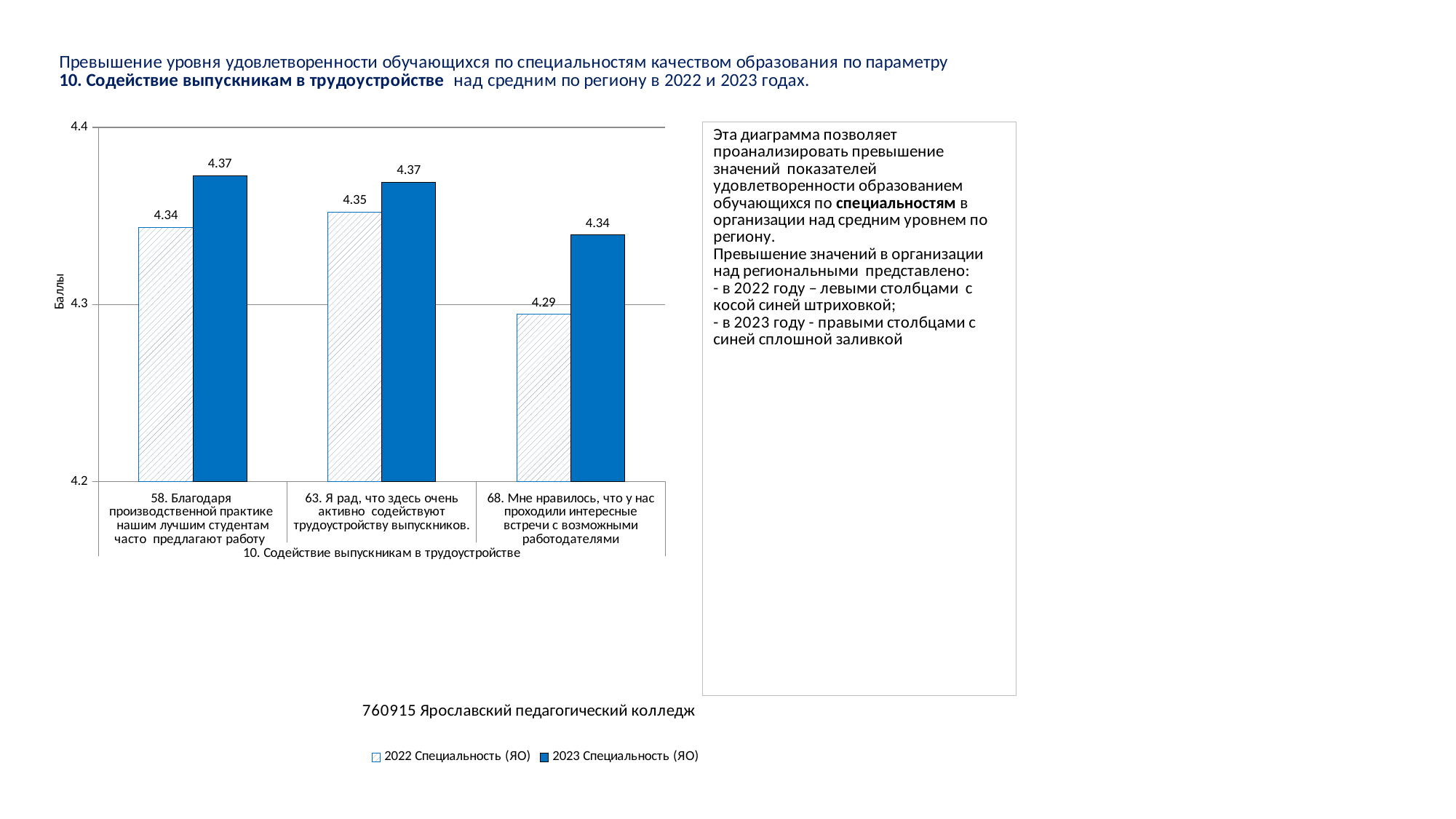
Which is larger for category 63: the 2022 Специальность (ЯО) value or the 2023 Специальность (ЯО) value? 2023 Специальность (ЯО) Which category has the lowest 2023 Специальность (ЯО) value? 68. Мне нравилось, что у нас проходили интересные встречи с возможными работодателями What is the 2023 Специальность (ЯО) value for category 68 (Мне нравилось, что у нас проходили интересные встречи с возможными работодателями)? 4.34 What is the difference between the 2023 and 2022 values for category 68 (Мне нравилось, что у нас проходили интересные встречи с возможными работодателями)? 0.05 What is the 2022 Специальность (ЯО) value for category 68 (Мне нравилось, что у нас проходили интересные встречи с возможными работодателями)? 4.29 Which category has the lowest 2022 Специальность (ЯО) value? 68. Мне нравилось, что у нас проходили интересные встречи с возможными работодателями How many series does the chart legend list? 2 How many categories are shown on the x axis of the chart? 3 What is the difference between the 2023 and 2022 values for category 58 (Благодаря производственной практике нашим лучшим студентам часто предлагают работу)? 0.03 Is the 2022 Специальность (ЯО) value for category 68 greater or less than 4.3? less What is the 2022 Специальность (ЯО) value for category 58 (Благодаря производственной практике нашим лучшим студентам часто предлагают работу)? 4.34 What is the 2023 Специальность (ЯО) value for category 63 (Я рад, что здесь очень активно содействуют трудоустройству выпускников)? 4.37